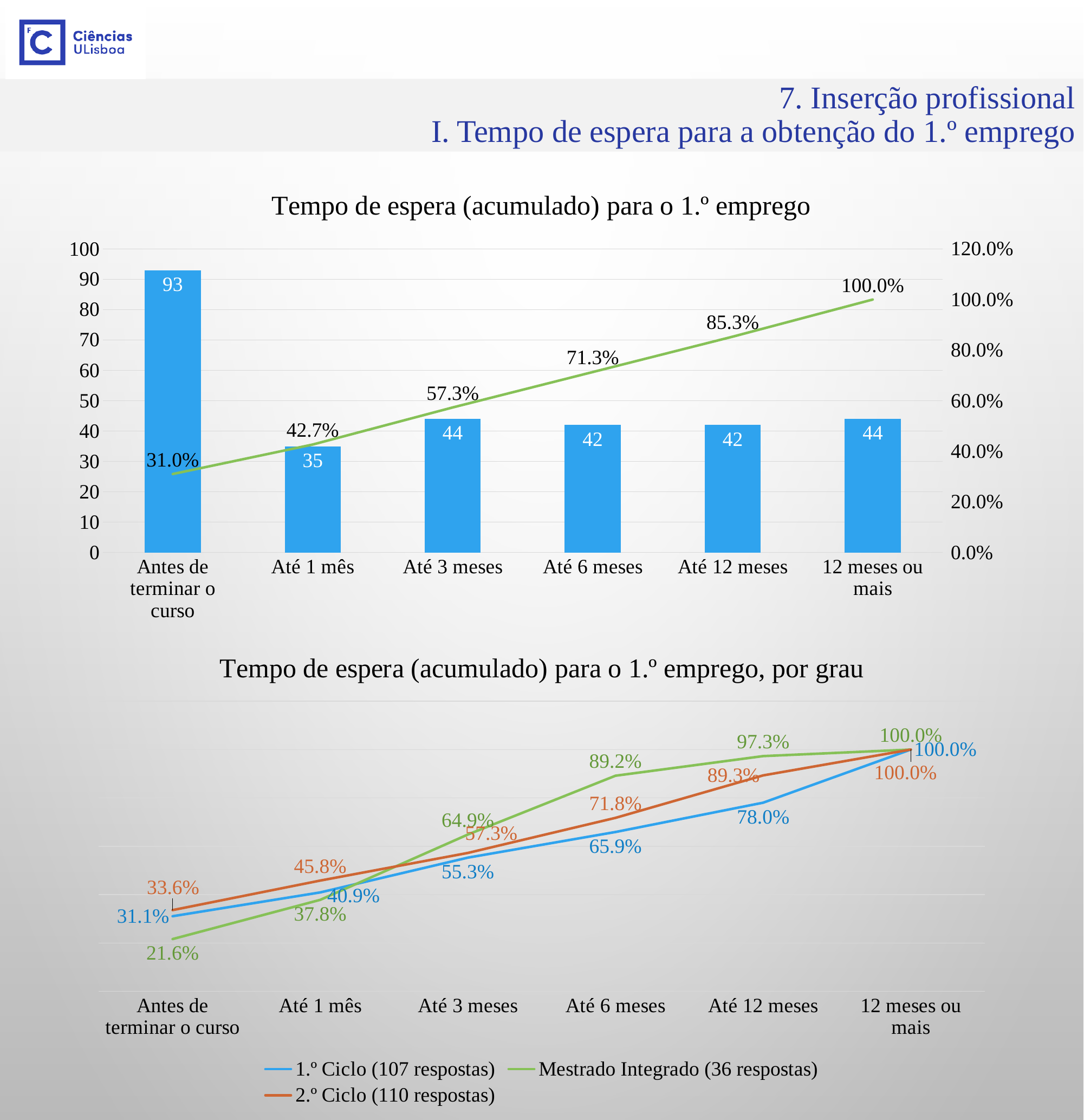
In the chart 'Tempo de espera (acumulado) para o 1.º emprego', which category has the lowest bar value? Até 1 mês In the chart 'Tempo de espera (acumulado) para o 1.º emprego', what is the difference between the bar values for 'Antes de terminar o curso' and 'Até 1 mês'? 58 In the chart 'Tempo de espera (acumulado) para o 1.º emprego', what is the cumulative percentage at 'Até 6 meses'? 71.3% In the chart 'Tempo de espera (acumulado) para o 1.º emprego, por grau', what is the value for 'Mestrado Integrado (36 respostas)' at 'Antes de terminar o curso'? 21.6% In the chart 'Tempo de espera (acumulado) para o 1.º emprego, por grau', how many series does the legend list? 3 In the chart 'Tempo de espera (acumulado) para o 1.º emprego, por grau', what is the difference between the '2.º Ciclo (110 respostas)' and '1.º Ciclo (107 respostas)' values at 'Até 12 meses'? 11.3% In the chart 'Tempo de espera (acumulado) para o 1.º emprego, por grau', at 'Até 1 mês', which is larger: the value for '2.º Ciclo (110 respostas)' or for '1.º Ciclo (107 respostas)'? 2.º Ciclo (110 respostas) In the chart 'Tempo de espera (acumulado) para o 1.º emprego, por grau', which series has the highest value at 'Até 6 meses'? Mestrado Integrado (36 respostas) In the chart 'Tempo de espera (acumulado) para o 1.º emprego', does the green line rise or fall from left to right? rise In the chart 'Tempo de espera (acumulado) para o 1.º emprego', what is the bar value for 'Antes de terminar o curso'? 93 In the chart 'Tempo de espera (acumulado) para o 1.º emprego', how many categories are shown on the x axis? 6 In the chart 'Tempo de espera (acumulado) para o 1.º emprego, por grau', what is the value for '1.º Ciclo (107 respostas)' at 'Até 12 meses'? 78.0%